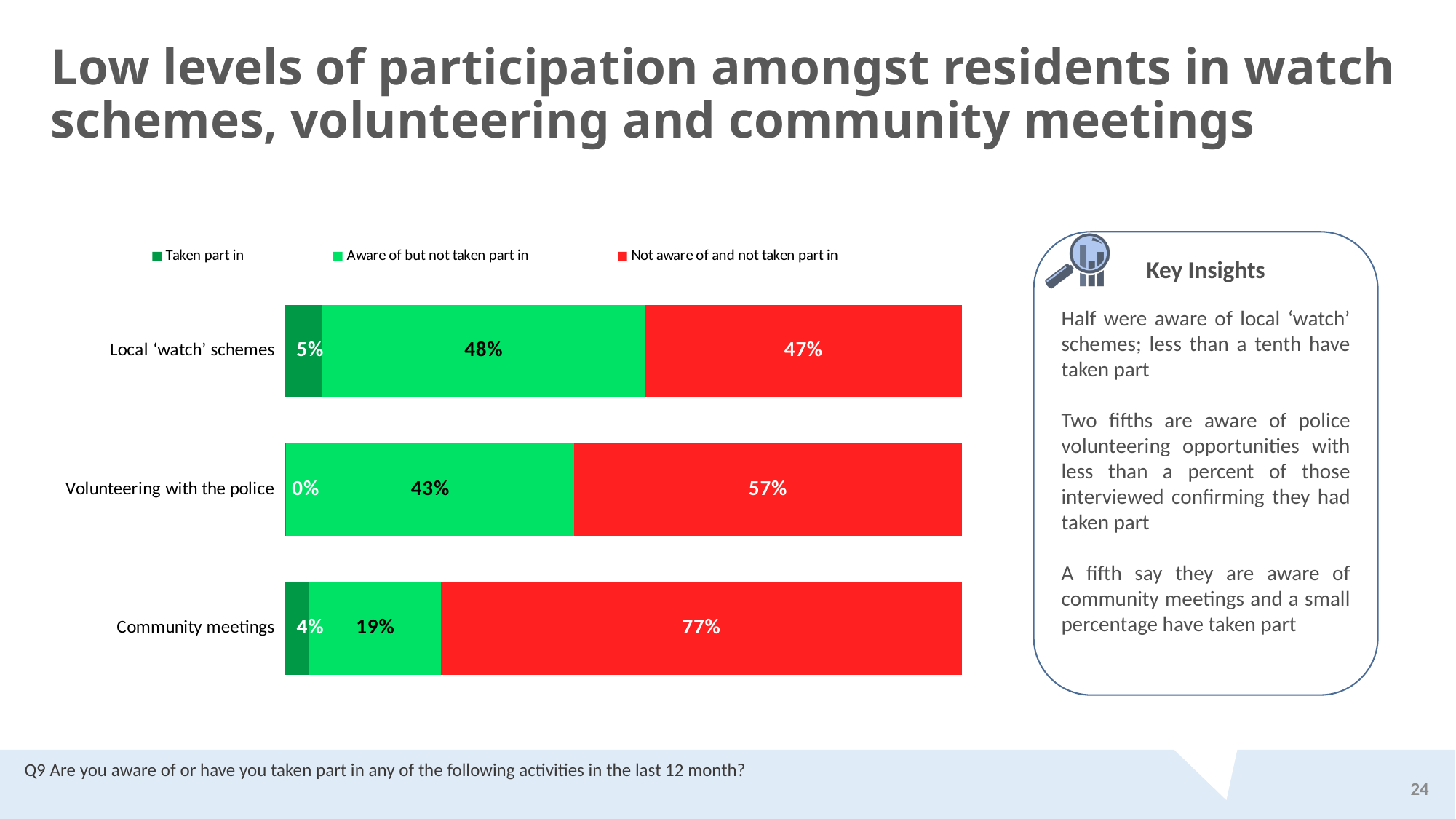
What percentage of residents were 'Not aware of and not taken part in' Community meetings? 77% What type of chart is shown on the slide? Stacked bar chart How many series does the legend list? 3 What is the difference between the 'Not aware of and not taken part in' percentages for Community meetings and Local 'watch' schemes? 30 percentage points What percentage of residents had 'Taken part in' Volunteering with the police? 0% What percentage of residents were 'Not aware of and not taken part in' Volunteering with the police? 57% What percentage of residents were 'Aware of but not taken part in' Local 'watch' schemes? 48% How many activities are shown in the chart? 3 Which activity has the lowest 'Aware of but not taken part in' percentage? Community meetings Which colour represents 'Not aware of and not taken part in' in the chart? Red Which activity has the highest 'Not aware of and not taken part in' percentage? Community meetings Which is larger: the 'Aware of but not taken part in' share for Local 'watch' schemes or for Volunteering with the police? Local 'watch' schemes